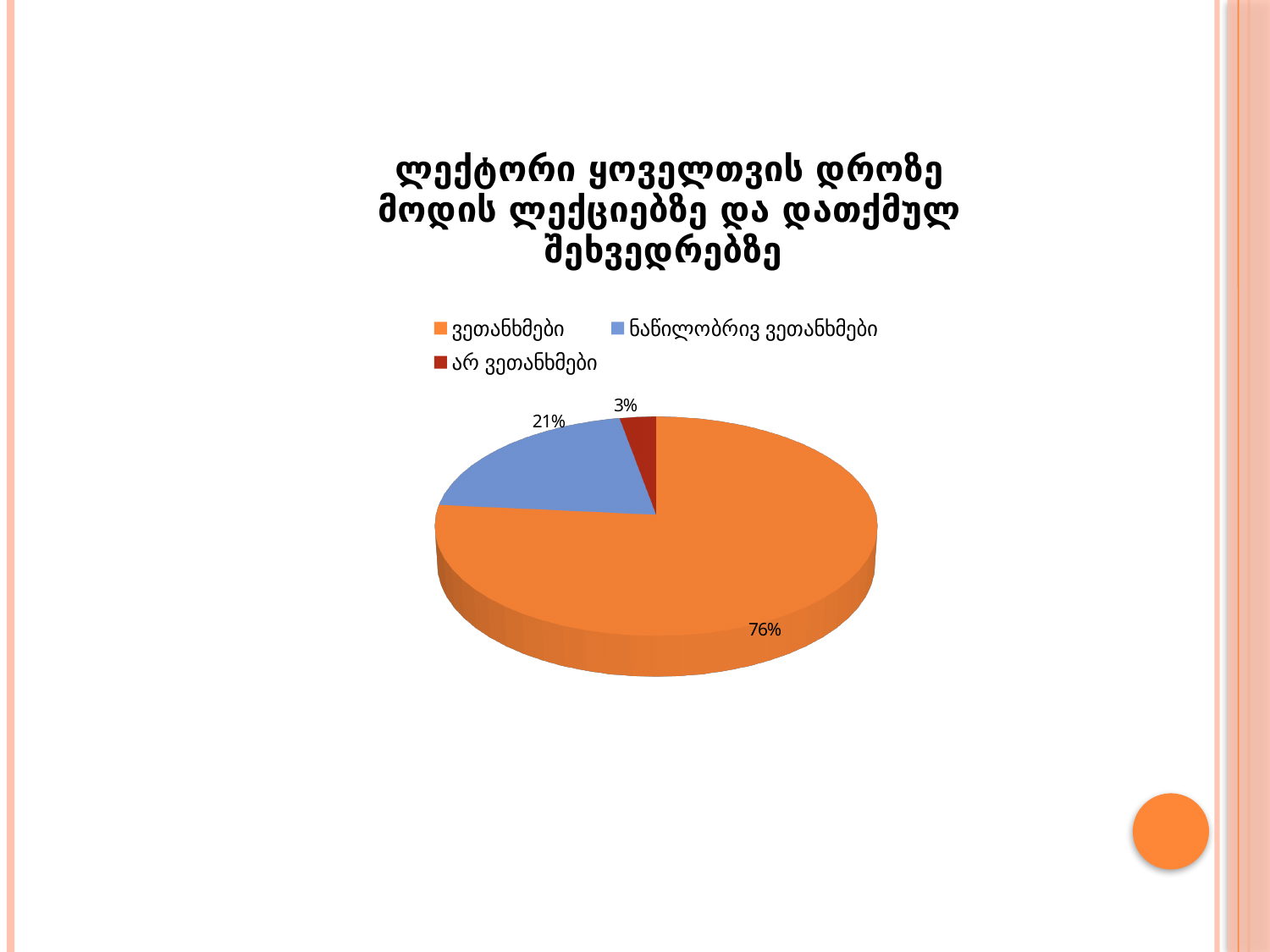
What share of the pie does ნაწილობრივ ვეთანხმები have? 21% What share of the pie does ვეთანხმები have? 76% What kind of chart is shown on the slide? pie chart Which category has the smallest slice of the pie? არ ვეთანხმები What share of the pie does არ ვეთანხმები have? 3% What colour is the slice for ნაწილობრივ ვეთანხმები? blue What is the difference in percentage points between ნაწილობრივ ვეთანხმები and არ ვეთანხმები? 18 Which is larger, the slice for ნაწილობრივ ვეთანხმები or the slice for არ ვეთანხმები? ნაწილობრივ ვეთანხმები How many entries does the legend list? 3 Which category has the largest slice of the pie? ვეთანხმები How many slices does the pie chart have? 3 What is the difference in percentage points between ვეთანხმები and ნაწილობრივ ვეთანხმები? 55